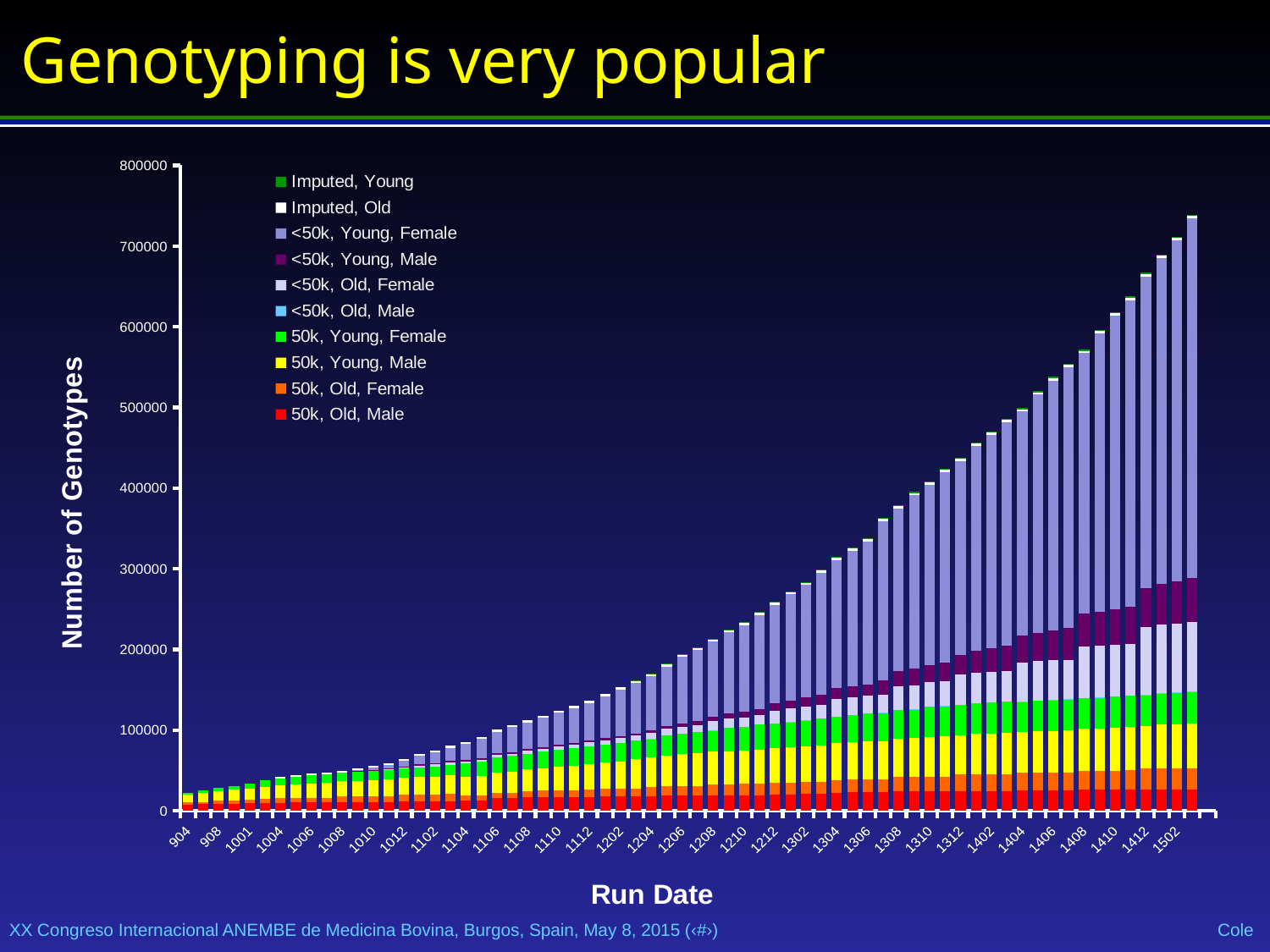
What kind of chart is shown on the slide? stacked bar chart Which run date has a larger total number of genotypes, 1502 or 1206? 1502 Is the total number of genotypes for run date 904 greater or less than 100000? less How many series does the legend list? 10 Do the total number of genotypes rise or fall as the run date moves from 904 to 1502? rise Which run date has the lowest total number of genotypes? 904 What is the label of the vertical axis? Number of Genotypes Is the total number of genotypes for run date 1412 greater or less than 600000? greater Is the total number of genotypes for run date 1306 greater or less than 300000? greater